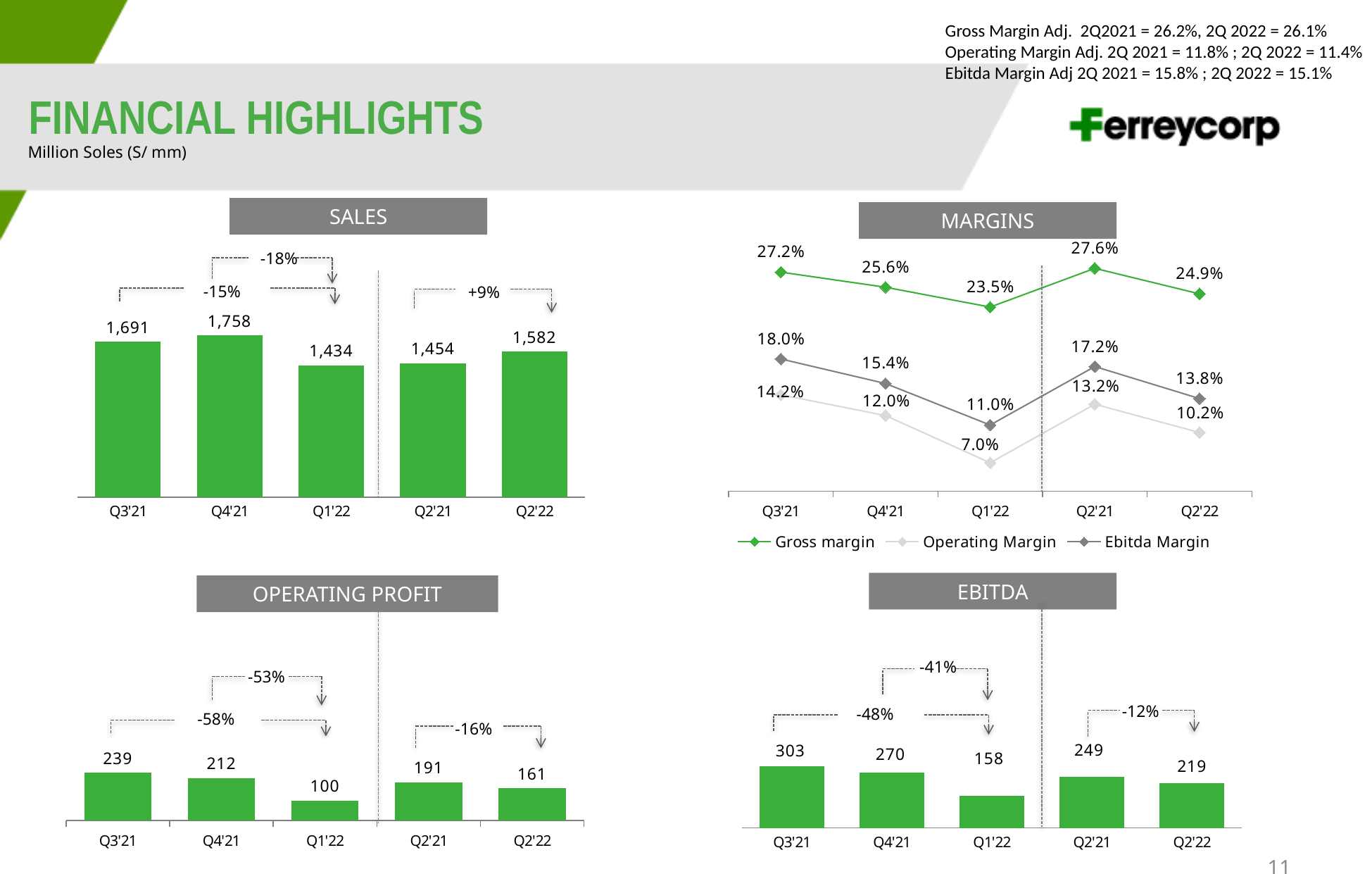
In the MARGINS chart, what is the Operating Margin for Q2'22? 10.2% How many quarters are shown on the x axis of the EBITDA chart? 5 What kind of chart is the MARGINS chart? Line chart How many series does the legend of the MARGINS chart list? 3 In the EBITDA chart, what is the value for Q2'22? 219 In the OPERATING PROFIT chart, which is larger, Q3'21 or Q4'21? Q3'21 In the MARGINS chart, what is the Gross margin for Q1'22? 23.5% In the OPERATING PROFIT chart, what is the value for Q1'22? 100 In the SALES chart, which quarter has the lowest value? Q1'22 In the MARGINS chart, which quarter has the highest Ebitda Margin? Q3'21 In the SALES chart, what is the difference between Q2'22 and Q2'21? 128 In the SALES chart, what is the value for Q4'21? 1,758